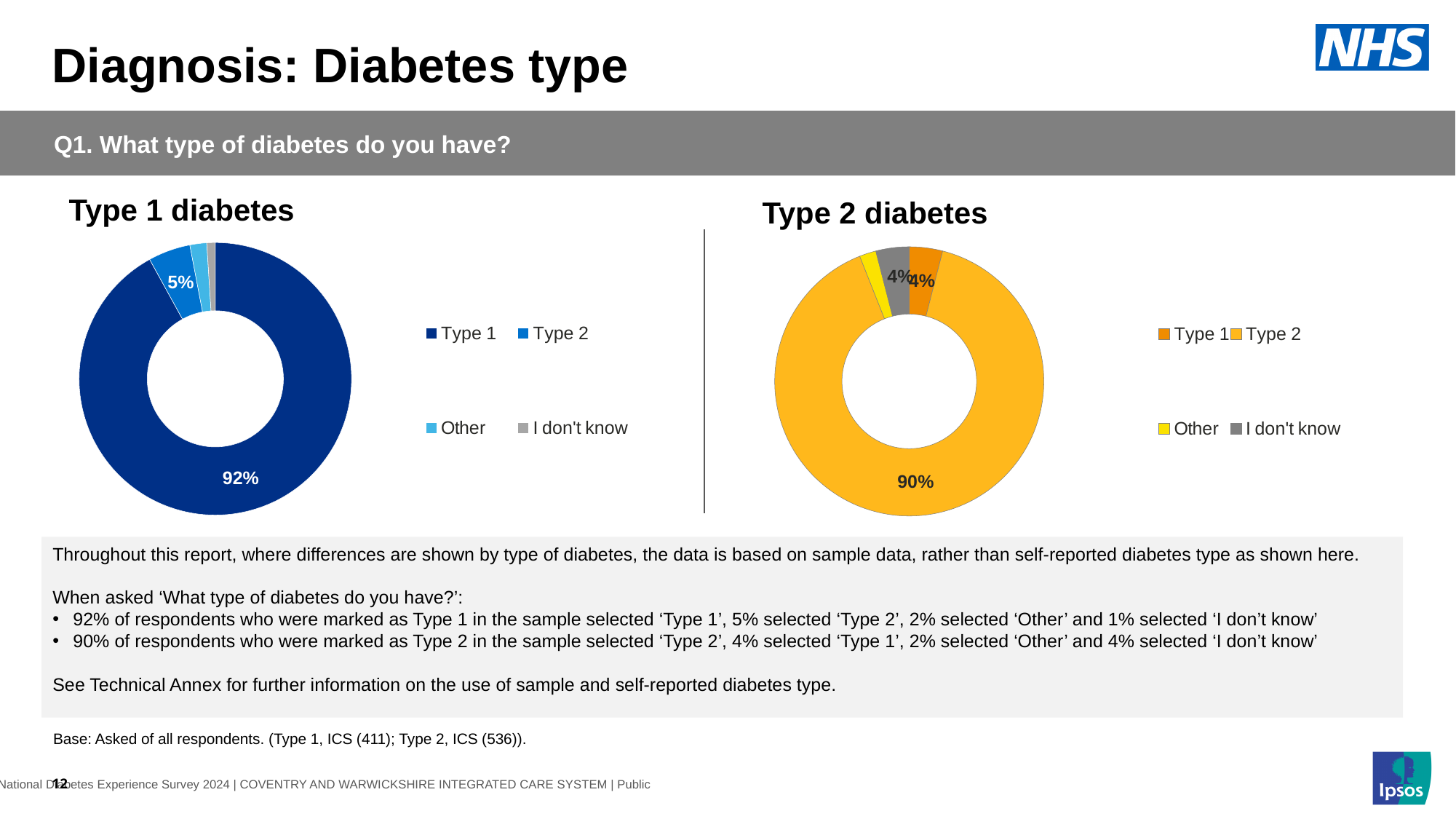
In the Type 1 diabetes chart, what is the difference in percentage points between the 'Type 1' and 'Type 2' slices? 87 percentage points In the Type 1 diabetes chart, what share of respondents selected 'Type 2'? 5% How many categories does the legend of the Type 1 diabetes chart list? 4 In the Type 2 diabetes chart, what share of respondents selected 'Type 2'? 90% In the Type 2 diabetes chart, what share of respondents selected 'Type 1'? 4% In the Type 2 diabetes chart, which category has the largest slice? Type 2 In the Type 1 diabetes chart, which category has the largest slice? Type 1 Which is larger: the 'Type 1' slice in the Type 1 diabetes chart or the 'Type 2' slice in the Type 2 diabetes chart? The 'Type 1' slice in the Type 1 diabetes chart (92%) In the Type 2 diabetes chart, what is the difference in percentage points between the 'Type 2' and 'Type 1' slices? 86 percentage points In the Type 2 diabetes chart, what colour is the 'Other' slice? Yellow In the Type 1 diabetes chart, what share of respondents selected 'Type 1'? 92% What kind of chart is the Type 2 diabetes chart? Donut (pie) chart